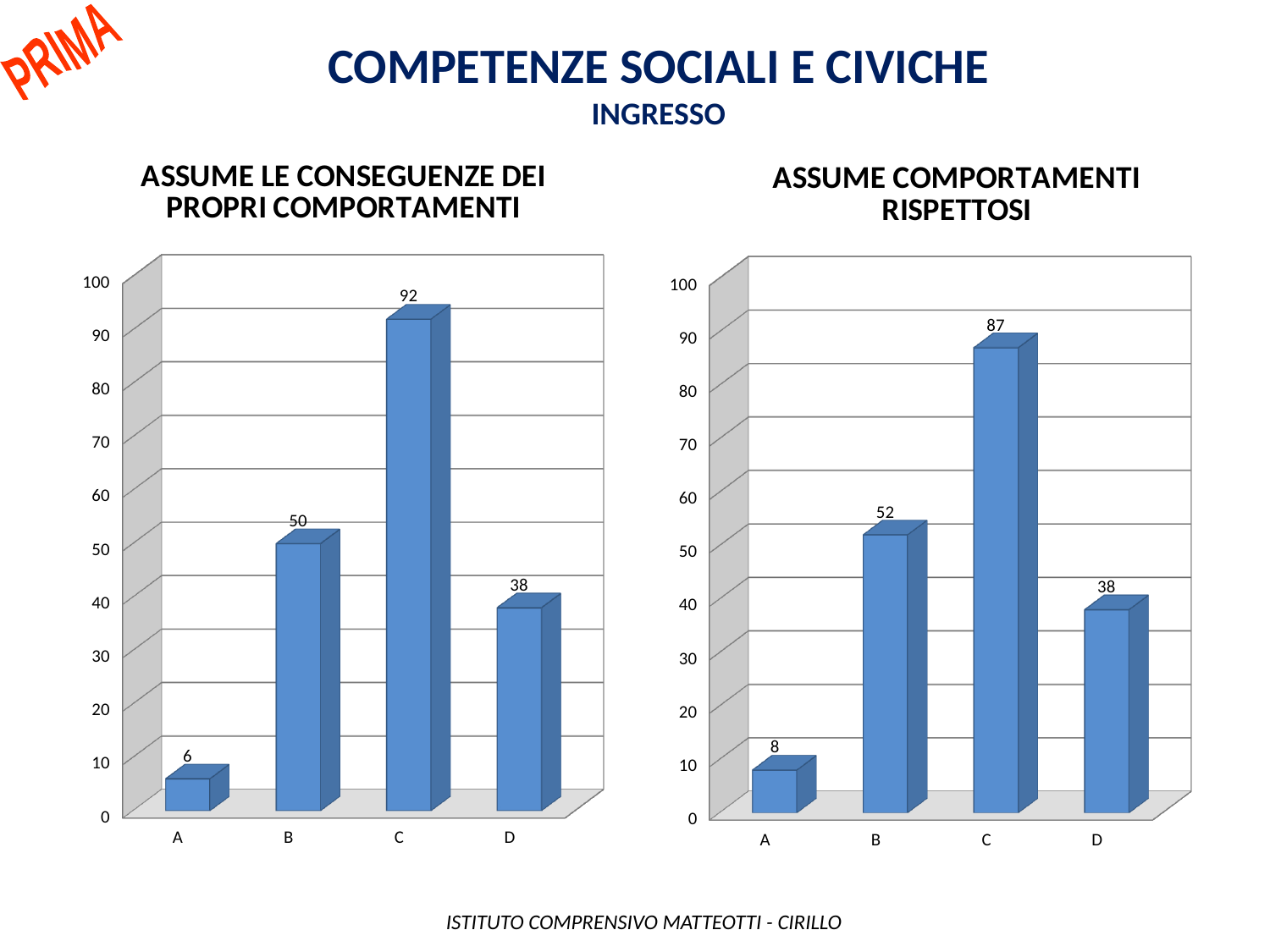
In the left chart, which category has the lowest value? A In the right chart, which category has the highest value? C In the right chart, is the value for D greater or less than 40? less How many categories are shown in the chart titled 'ASSUME COMPORTAMENTI RISPETTOSI'? 4 What kind of chart is the chart titled 'ASSUME LE CONSEGUENZE DEI PROPRI COMPORTAMENTI'? bar chart In the left chart, what is the difference between the values for B and D? 12 In the left chart, which is larger, the value for B or the value for D? B In the right chart, what is the value for category B? 52 In the right chart, what is the difference between the values for C and B? 35 In the chart titled 'ASSUME LE CONSEGUENZE DEI PROPRI COMPORTAMENTI', what is the value for category C? 92 What is the title of the chart on the right side of the slide? ASSUME COMPORTAMENTI RISPETTOSI In the chart titled 'ASSUME COMPORTAMENTI RISPETTOSI', what is the value for category A? 8